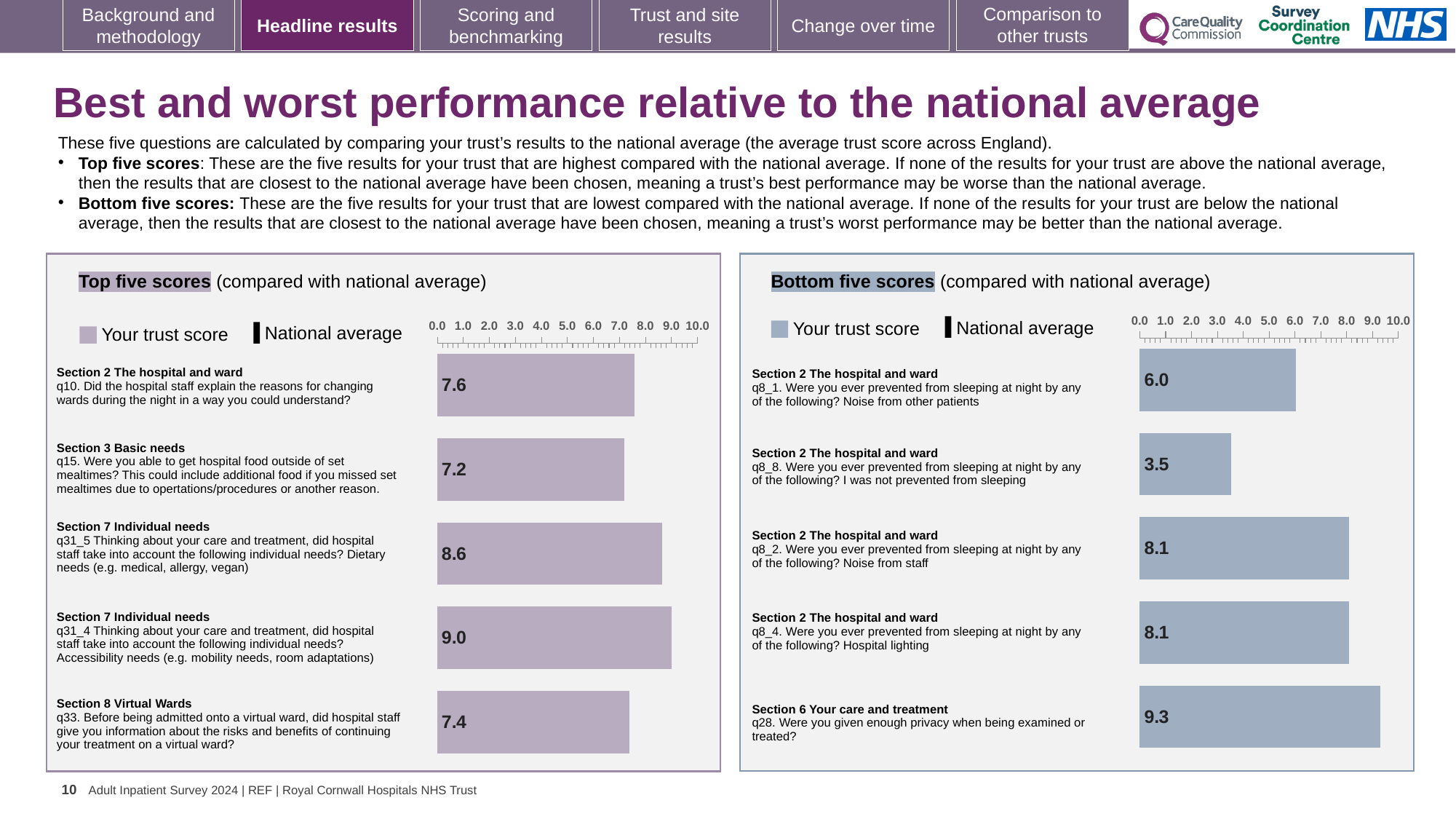
In the Bottom five scores chart, which question has the highest trust score? q28 (enough privacy when being examined or treated) In the Bottom five scores chart, which question has the lowest trust score? q8_8 (I was not prevented from sleeping) In the Top five scores chart, which question has the highest trust score? q31_4 (Accessibility needs) How many entries does the legend of the Bottom five scores chart list? 2 In the Bottom five scores chart, which has the larger score: q8_1 (Noise from other patients) or q8_2 (Noise from staff)? q8_2 (Noise from staff) In the Top five scores chart, which question has the lowest trust score? q15 (hospital food outside of set mealtimes) What type of chart is used in the Top five scores panel? Bar chart In the Bottom five scores chart, what is the trust score for q8_8 (I was not prevented from sleeping)? 3.5 In the Top five scores chart, what is the difference between the scores for q31_4 and q33? 1.6 In the Bottom five scores chart, what is the difference between the scores for q28 and q8_1? 3.3 In the Top five scores chart, what is the trust score for q10 (explaining reasons for changing wards during the night)? 7.6 In the Top five scores chart, how many questions are shown? 5